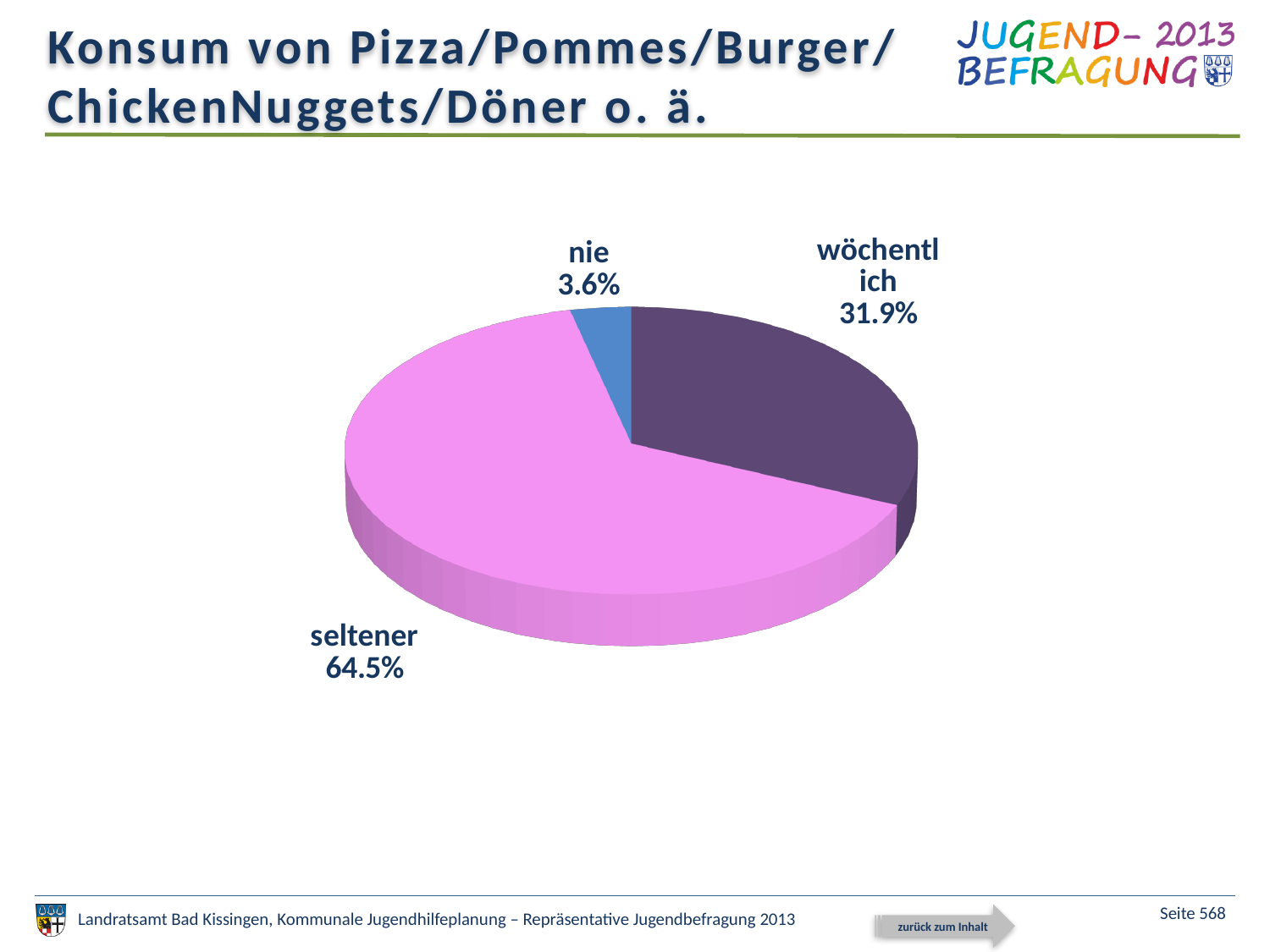
What share of the pie does "nie" have? 3.6% How many slices does the pie chart have? 3 What colour is the "seltener" slice? pink What share of the pie does "seltener" have? 64.5% What is the title of the slide containing the chart? Konsum von Pizza/Pommes/Burger/ChickenNuggets/Döner o. ä. Which is larger, the share for "wöchentlich" or the share for "nie"? wöchentlich What is the difference in percentage points between "wöchentlich" and "nie"? 28.3 What is the difference in percentage points between "seltener" and "wöchentlich"? 32.6 What kind of chart is shown on the slide? pie chart What share of the pie does "wöchentlich" have? 31.9% Which category has the smallest slice of the pie? nie Which category has the largest slice of the pie? seltener